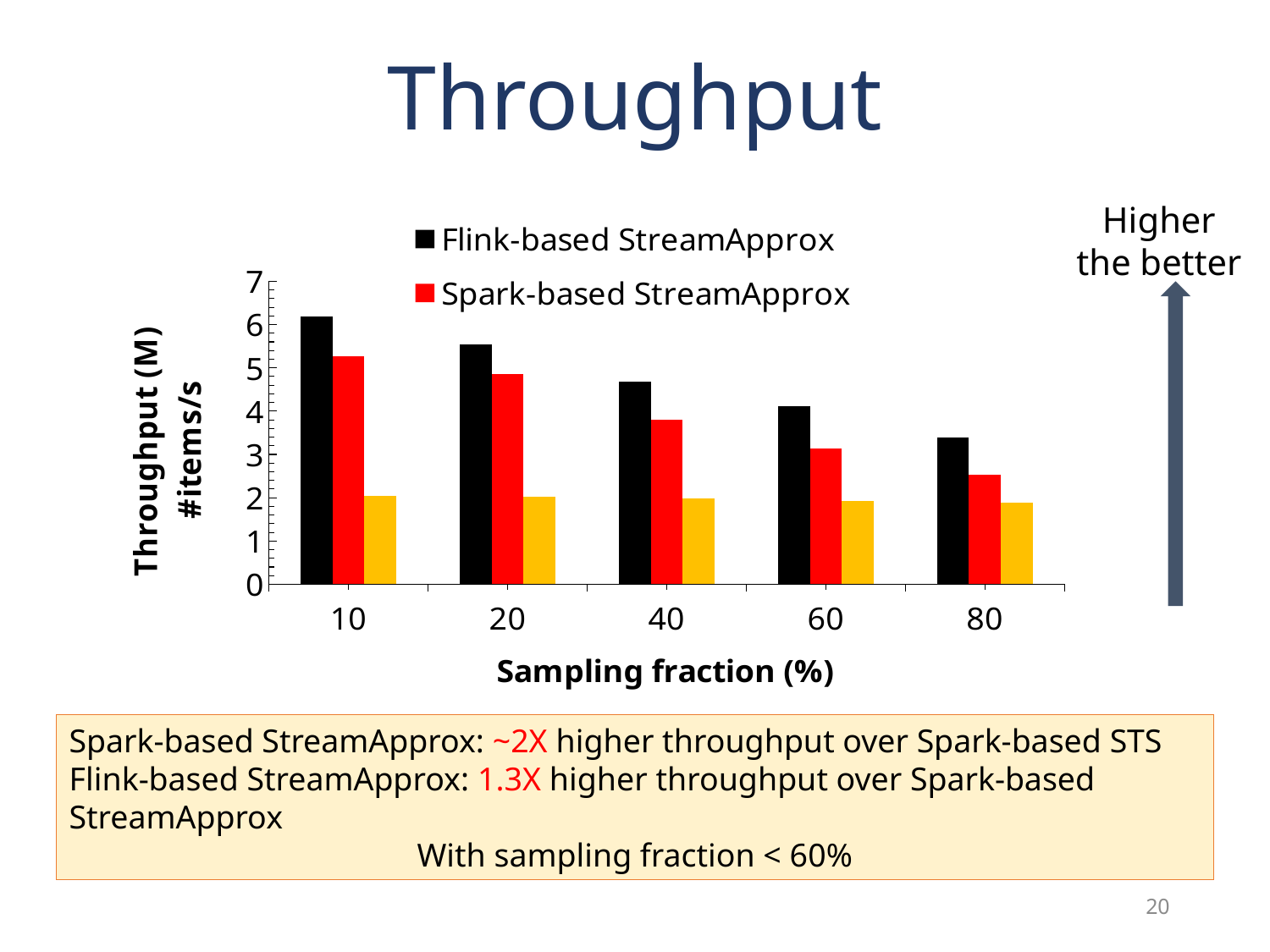
Is the throughput of Flink-based StreamApprox at sampling fraction 10 greater or less than 5? greater What is the title of the x axis? Sampling fraction (%) How does the throughput of Flink-based StreamApprox change as the sampling fraction increases from 10 to 80? It falls How many series does the legend list? 2 Is the throughput of Spark-based StreamApprox at sampling fraction 10 greater or less than 4? greater At which sampling fraction is the throughput of Flink-based StreamApprox highest? 10 What kind of chart is shown on the slide? bar chart At sampling fraction 20, which has the higher throughput: Flink-based StreamApprox or Spark-based StreamApprox? Flink-based StreamApprox Is the throughput of Spark-based StreamApprox at sampling fraction 80 greater or less than 3? less How many sampling fraction categories are shown on the x axis? 5 At which sampling fraction is the throughput of Spark-based StreamApprox lowest? 80